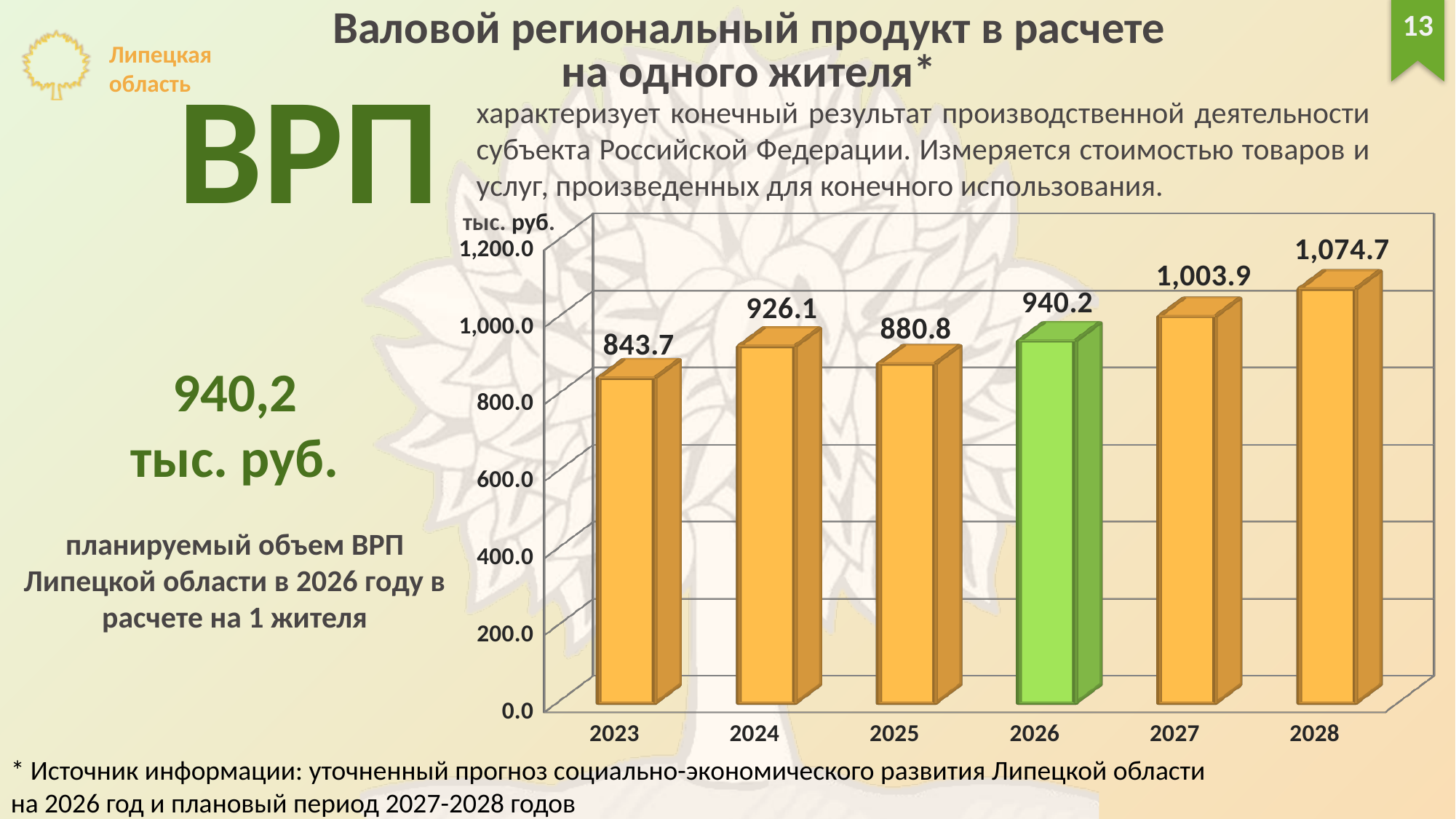
Which year has the lowest value on the chart? 2023 What is the value for 2028 on the chart? 1,074.7 Does the value rise or fall from 2024 to 2025? fall Which year's bar is coloured green on the chart? 2026 How many years are shown on the chart? 6 Which year has the highest value on the chart? 2028 What is the value for 2026 on the chart? 940.2 What is the value for 2023 on the chart? 843.7 What kind of chart is shown on the slide? bar chart Which is larger, the value for 2024 or the value for 2025? 2024 What is the difference between the values for 2024 and 2025? 45.3 What is the difference between the values for 2028 and 2027? 70.8